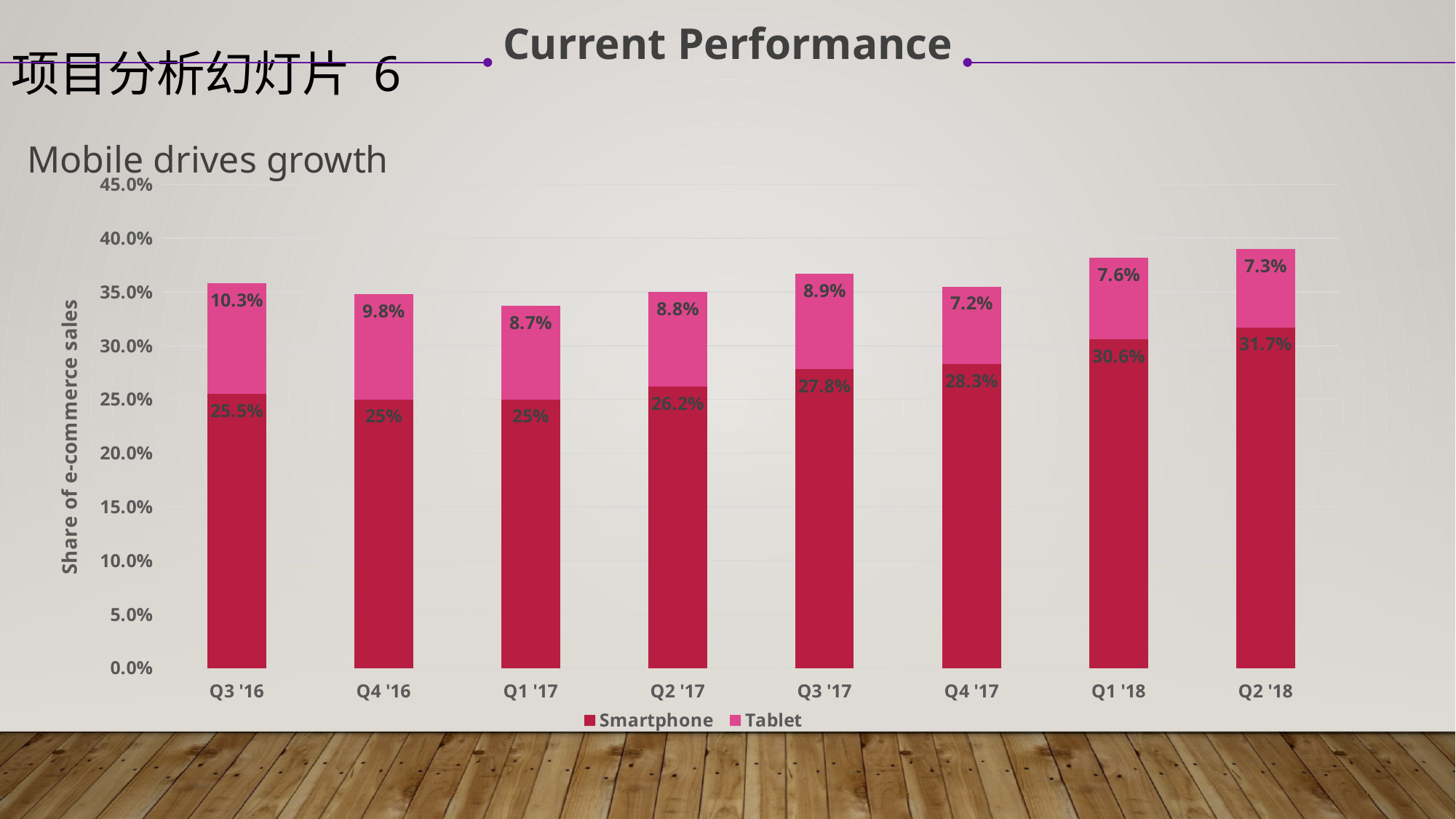
What is the Tablet share of e-commerce sales in Q3 '16? 10.3% How many series does the legend list? 2 Is the Tablet share larger in Q4 '16 or in Q1 '18? Q4 '16 Does the Tablet share generally rise or fall from Q3 '16 to Q2 '18? Fall What kind of chart is shown on the slide? Stacked bar chart What is the Smartphone share of e-commerce sales in Q2 '18? 31.7% What is the Smartphone value for Q4 '17? 28.3% Which quarter has the lowest Tablet share? Q4 '17 How many quarters are shown on the x axis? 8 Which quarter has the highest Smartphone share? Q2 '18 What is the total stacked value (Smartphone plus Tablet) for Q2 '18? 39.0% What is the difference between the Smartphone share in Q2 '18 and in Q3 '16? 6.2%